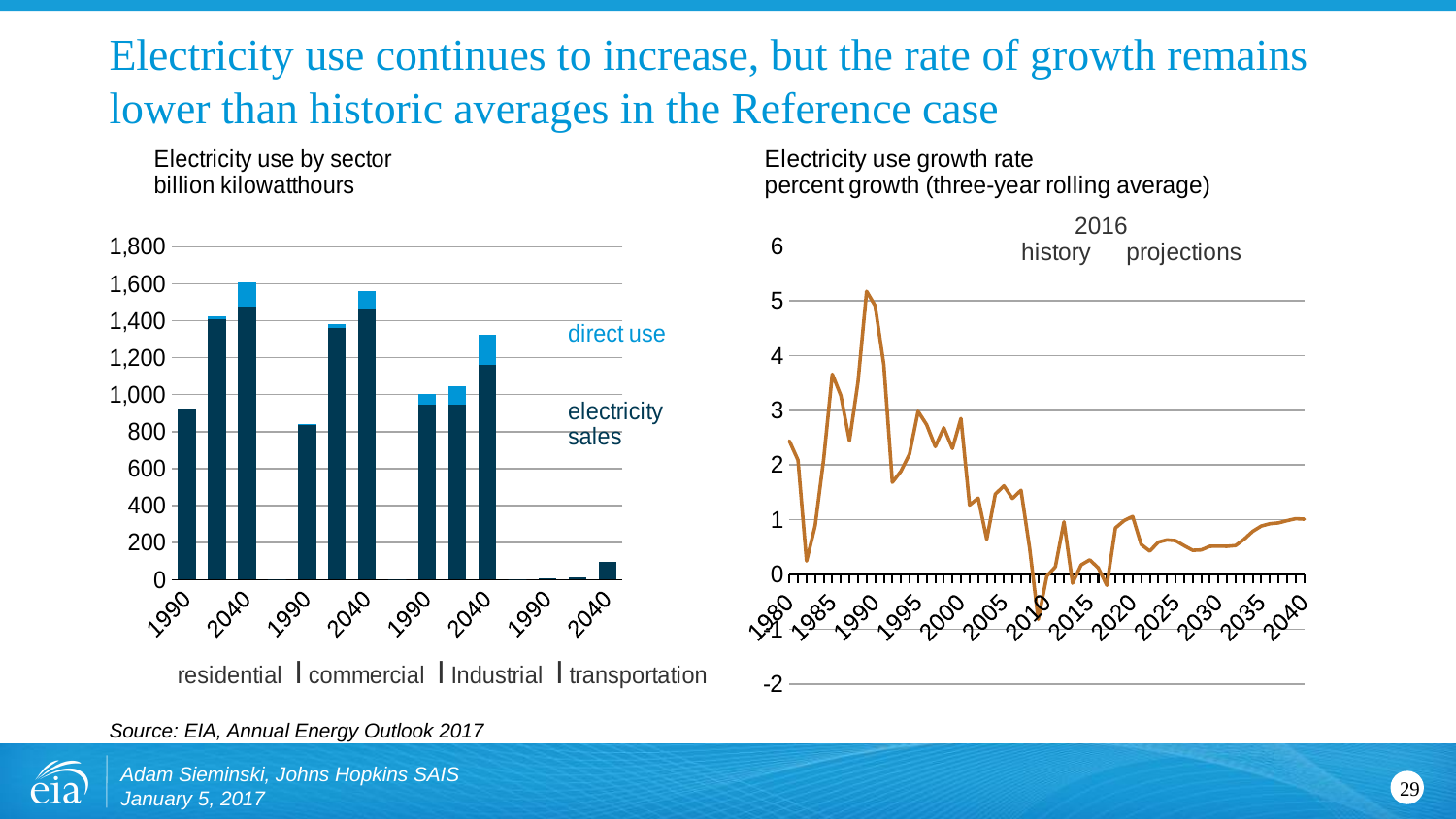
In the 'Electricity use by sector' chart, which is larger in 2040: the total for residential or the total for Industrial? residential In the 'Electricity use by sector' chart, is the total for commercial in 1990 greater or less than 1,000 billion kilowatthours? less In the 'Electricity use by sector' chart, how many sectors are shown along the x axis? 4 In the 'Electricity use by sector' chart, what are the two series that make up each stacked bar? electricity sales and direct use What kind of chart is the 'Electricity use by sector' chart on the left? bar chart In the 'Electricity use by sector' chart, which sector has the lowest electricity use in 2040? transportation In the 'Electricity use by sector' chart, how many series make up each stacked bar? 2 In the 'Electricity use by sector' chart, is the total for transportation in 2040 greater or less than 200 billion kilowatthours? less In the 'Electricity use growth rate' chart, is the peak value around 1990 greater or less than 5 percent? greater What kind of chart is the 'Electricity use growth rate' chart on the right? line chart In the 'Electricity use growth rate' chart, what year separates history from projections? 2016